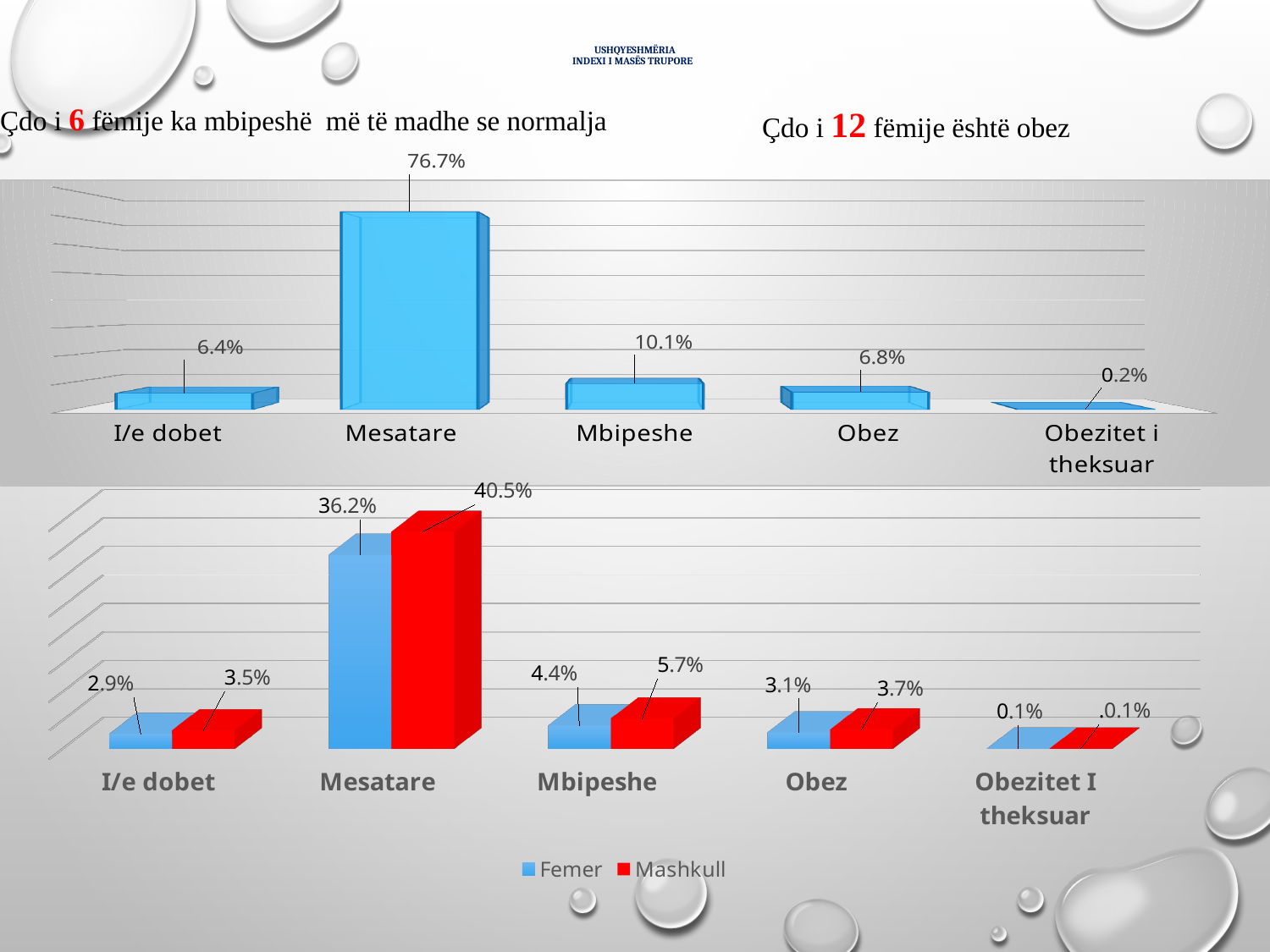
In the top chart, how many categories are shown? 5 In the bottom chart, what is the Mashkull value for Mesatare? 40.5% In the top chart, what is the difference between the values for Obez and I/e dobet? 0.4% In the top chart, what is the value for Mesatare? 76.7% What type of chart is the bottom chart? Bar chart In the bottom chart, which is larger for Obez: Femer or Mashkull? Mashkull In the bottom chart, which colour represents Mashkull? Red In the bottom chart, what is the difference between the Mashkull and Femer values for Mesatare? 4.3% In the bottom chart, how many series does the legend list? 2 In the bottom chart, what is the Femer value for Mbipeshe? 4.4% In the top chart, which category has the lowest value? Obezitet i theksuar In the top chart, what is the value for Mbipeshe? 10.1%